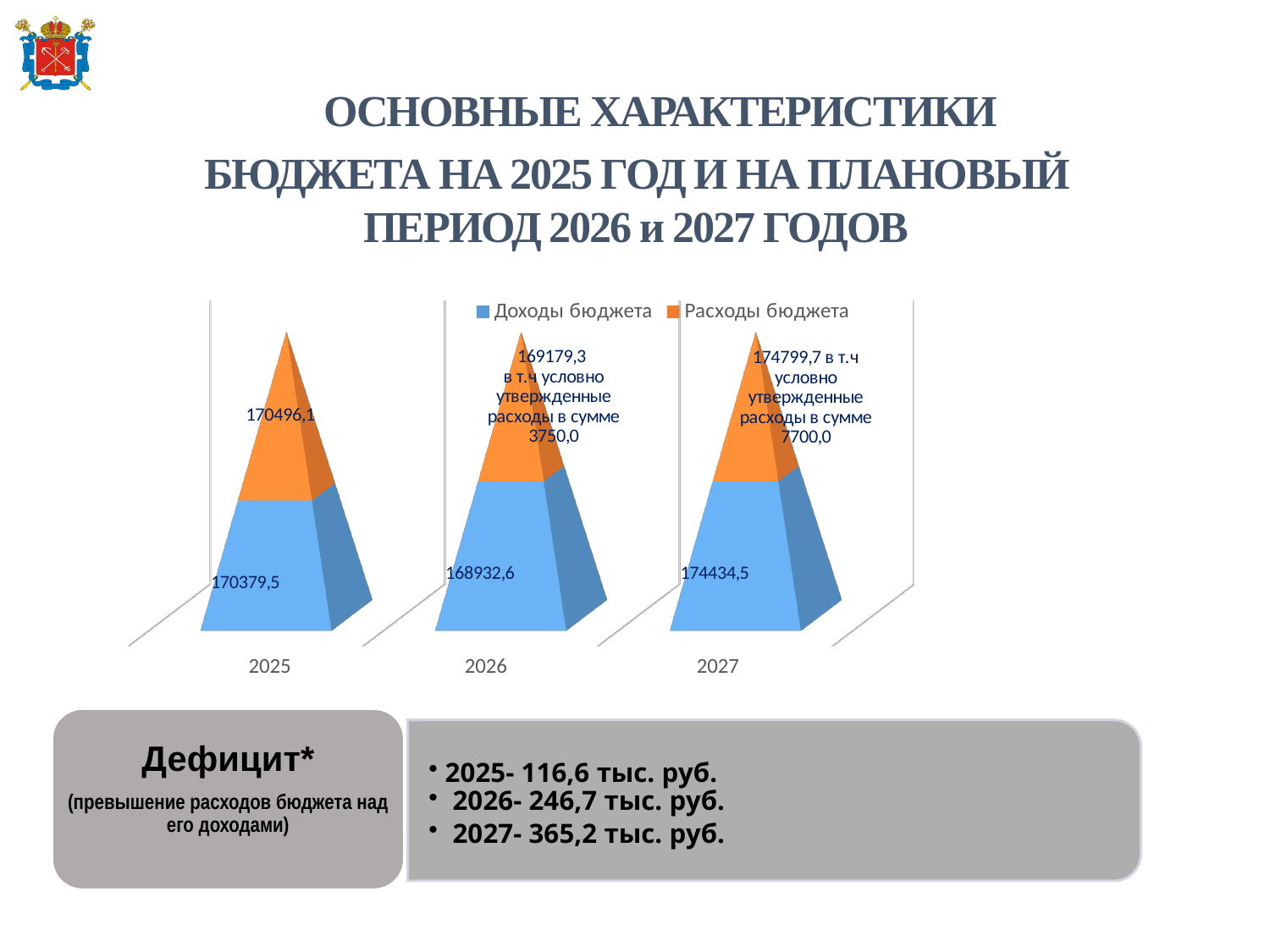
How many years are shown on the x axis of the chart? 3 What is the difference between Расходы бюджета and Доходы бюджета in 2025? 116,6 Which is larger: Доходы бюджета in 2025 or Доходы бюджета in 2026? 2025 What is the difference between Расходы бюджета and Доходы бюджета in 2027? 365,2 What is the value of Расходы бюджета for 2027? 174799,7 How many series does the chart legend list? 2 Which year has the lowest value of Расходы бюджета? 2026 What is the value of Доходы бюджета for 2026? 168932,6 What is the value of Доходы бюджета for 2025? 170379,5 Which colour represents Расходы бюджета in the chart? orange Which year has the highest value of Доходы бюджета? 2027 Does Доходы бюджета rise or fall from 2026 to 2027? rise